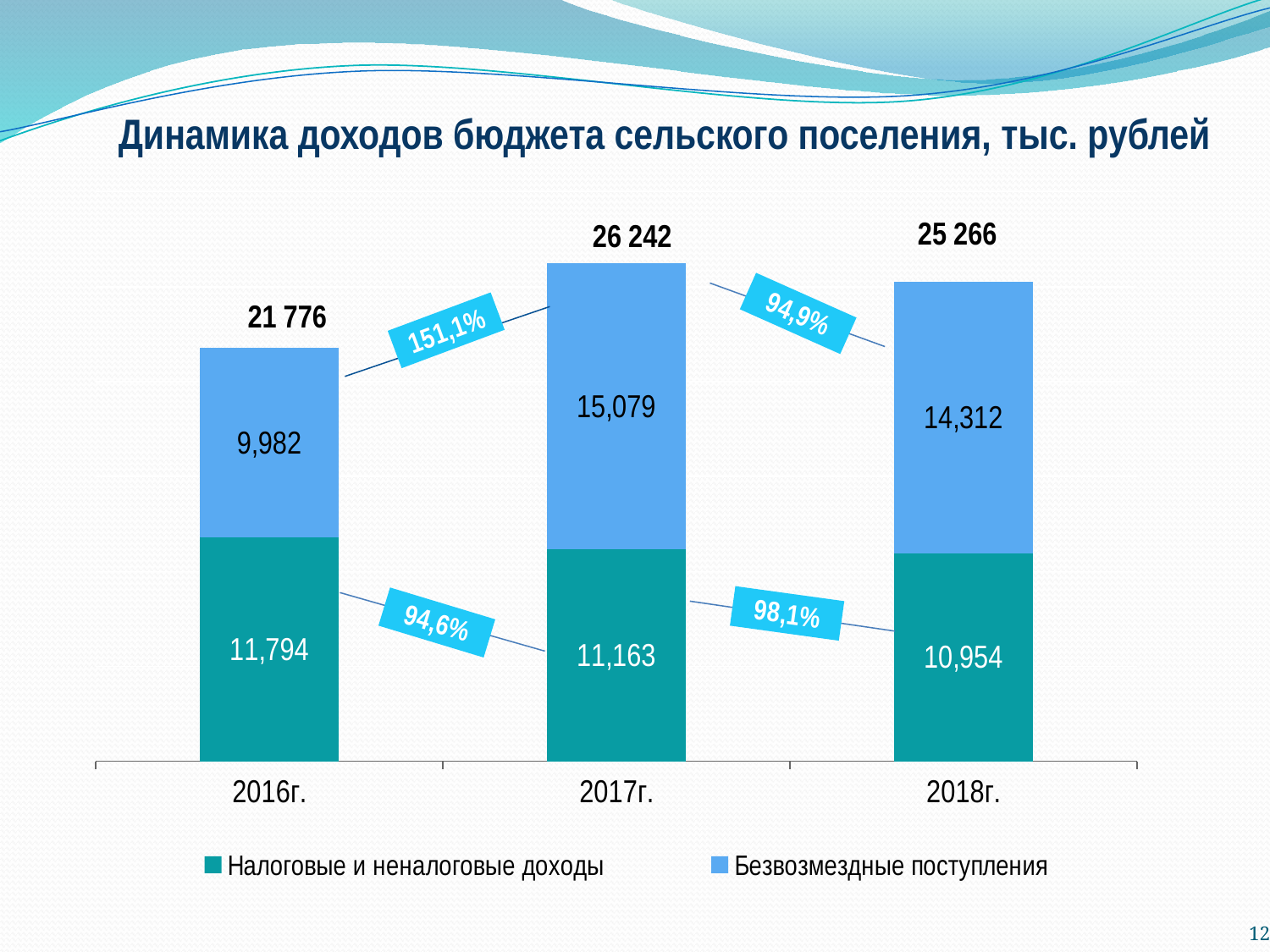
What is the total of the stacked bar for 2016г.? 21 776 What is the difference between Безвозмездные поступления in 2017г. and 2018г.? 767 How many years are shown on the x axis? 3 Which year has the highest total budget income? 2017г. What is the value for Безвозмездные поступления in 2018г.? 14,312 Which year has the lowest value for Налоговые и неналоговые доходы? 2018г. What kind of chart is shown on the slide? Stacked bar chart How many series does the legend list? 2 What is the total of the stacked bar for 2017г.? 26 242 What is the value for Налоговые и неналоговые доходы in 2016г.? 11,794 What is the value for Безвозмездные поступления in 2017г.? 15,079 Which is larger in 2016г.: Налоговые и неналоговые доходы or Безвозмездные поступления? Налоговые и неналоговые доходы